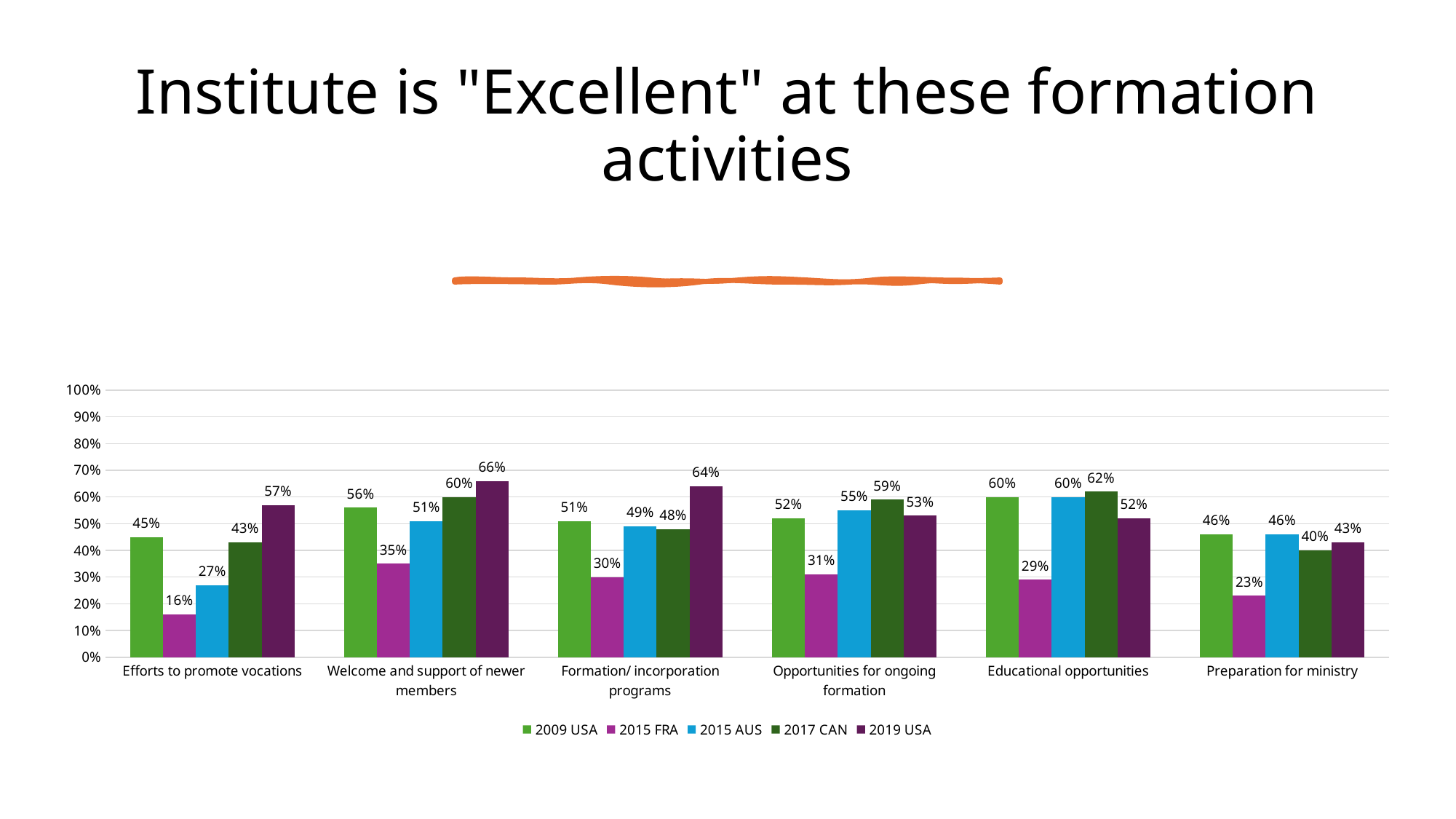
What kind of chart is shown on the slide? bar chart Which category has the lowest value for the 2015 FRA series? Efforts to promote vocations What is the title of the slide? Institute is "Excellent" at these formation activities How many categories are shown on the x axis? 6 Which series has the highest value in the Formation/ incorporation programs category? 2019 USA How many series does the legend list? 5 What is the value for 2015 FRA in the Efforts to promote vocations category? 16% Which is larger in the Educational opportunities category: 2017 CAN or 2019 USA? 2017 CAN What is the difference between the 2019 USA and 2015 FRA values in the Opportunities for ongoing formation category? 22% Is the value for 2015 AUS in the Efforts to promote vocations category greater or less than 30%? less What is the value for 2017 CAN in the Preparation for ministry category? 40% What is the value for 2019 USA in the Welcome and support of newer members category? 66%